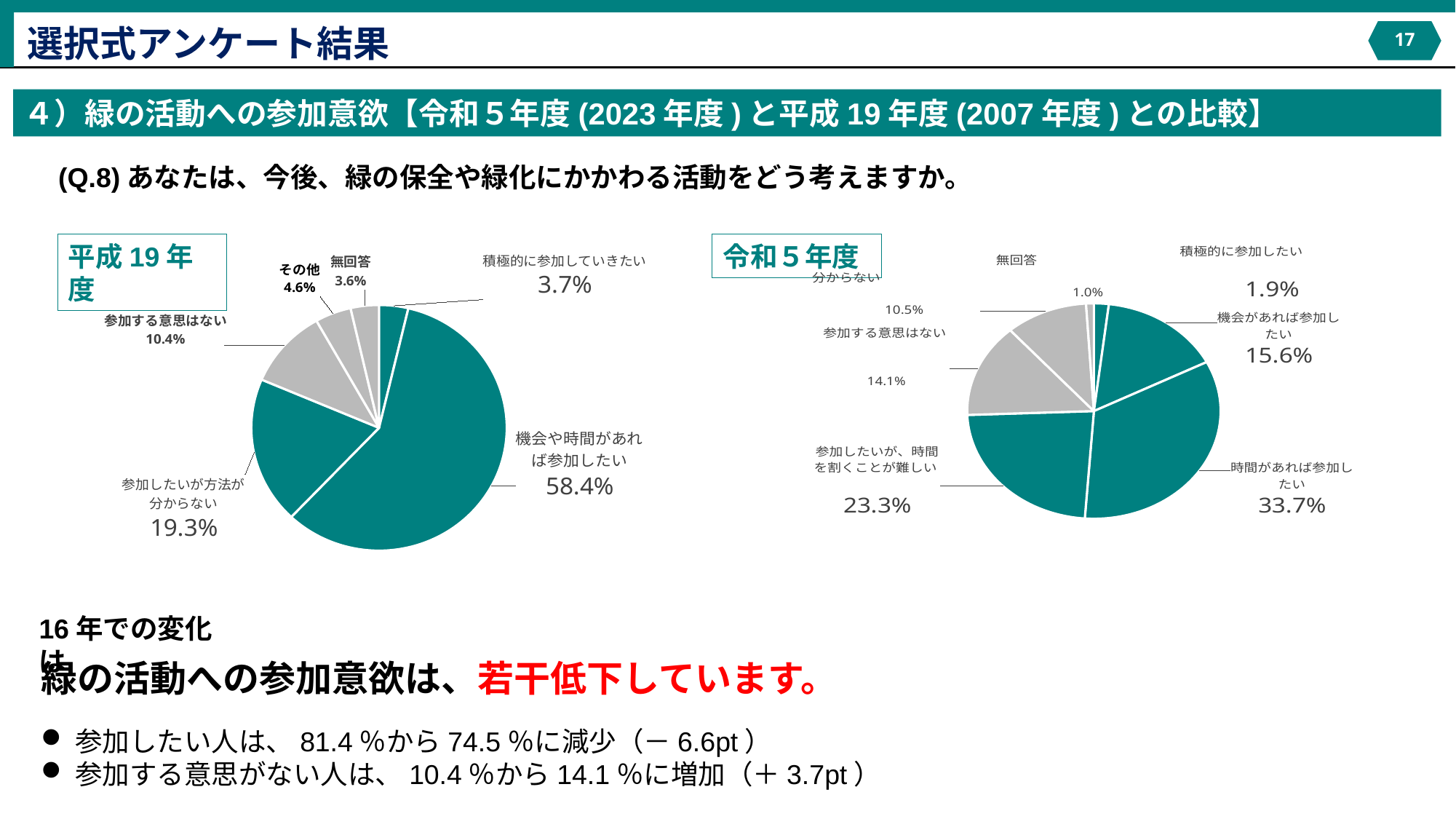
In the 令和5年度 pie chart, which category has the largest share? 時間があれば参加したい In the 令和5年度 pie chart, what is the share for 参加する意思はない? 14.1% In the 令和5年度 pie chart, how many slices are there? 7 In the 平成19年度 pie chart, how many slices are there? 6 Which is larger: 参加する意思はない in the 平成19年度 chart or 参加する意思はない in the 令和5年度 chart? 令和5年度 What kind of charts are shown on the slide? Pie charts In the 令和5年度 pie chart, what is the difference between 時間があれば参加したい and 参加したいが、時間を割くことが難しい? 10.4% In the 令和5年度 pie chart, what is the share for 時間があれば参加したい? 33.7% In the 平成19年度 pie chart, what is the share for 参加したいが方法が分からない? 19.3% In the 平成19年度 pie chart, which category has the smallest share? 無回答 In the 平成19年度 pie chart, what is the share for 機会や時間があれば参加したい? 58.4% In the 令和5年度 pie chart, which category has the smallest share? 無回答